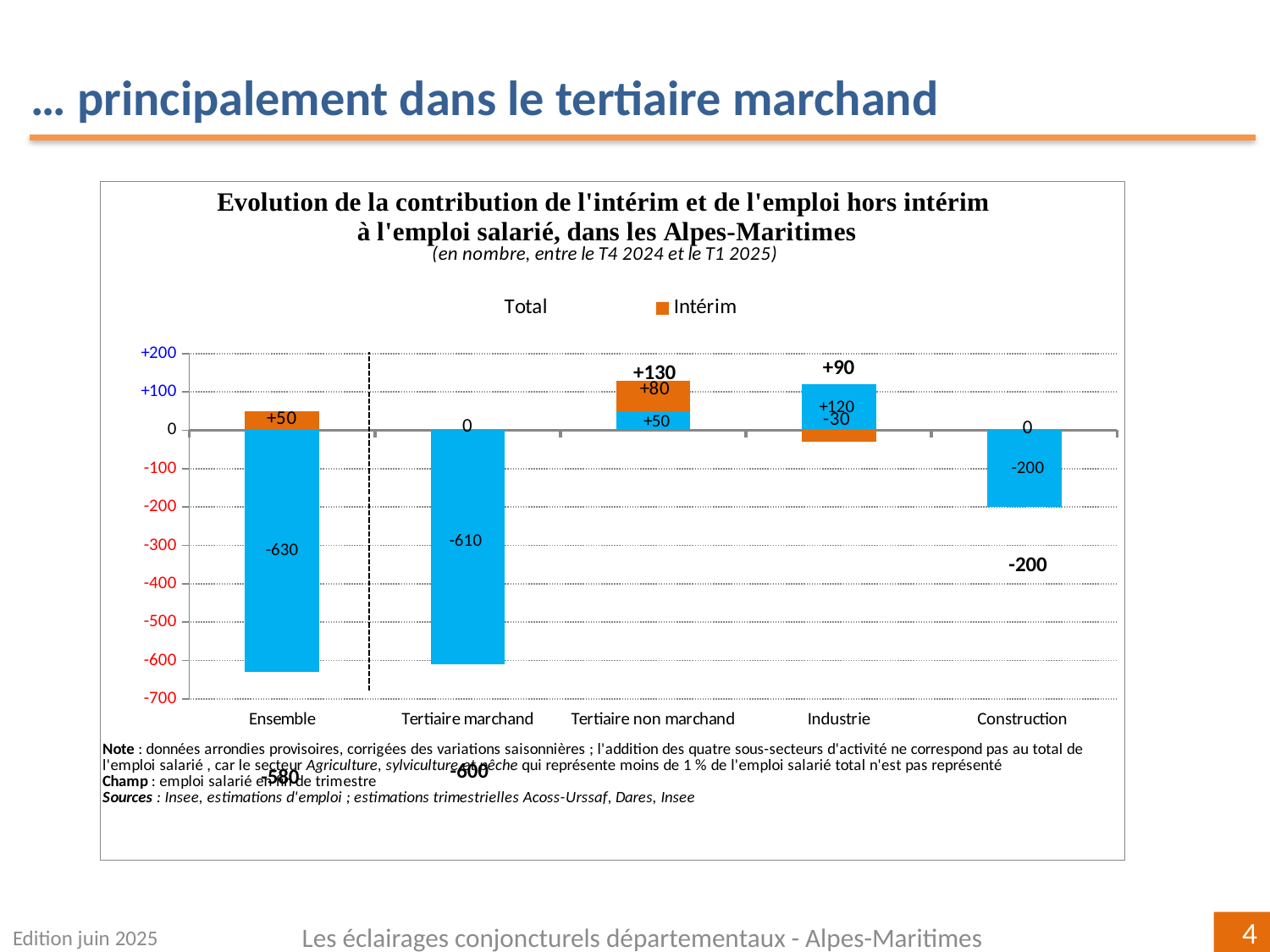
Which category has the highest Intérim value? Tertiaire non marchand What is the Intérim value for Industrie? -30 Which category has the lowest value for the blue bars? Ensemble What is the Intérim value for Construction? 0 What is the bold total value shown for Industrie? +90 Which is larger, the Intérim value for Ensemble or for Tertiaire non marchand? Tertiaire non marchand What is the bold total value shown for Tertiaire non marchand? +130 What kind of chart is shown on the slide? bar chart What is the difference between the blue bar values for Ensemble and Tertiaire marchand? 20 What is the Intérim value for Tertiaire non marchand? +80 What is the value of the blue bar for Ensemble? -630 How many categories are shown on the x axis of the chart? 5